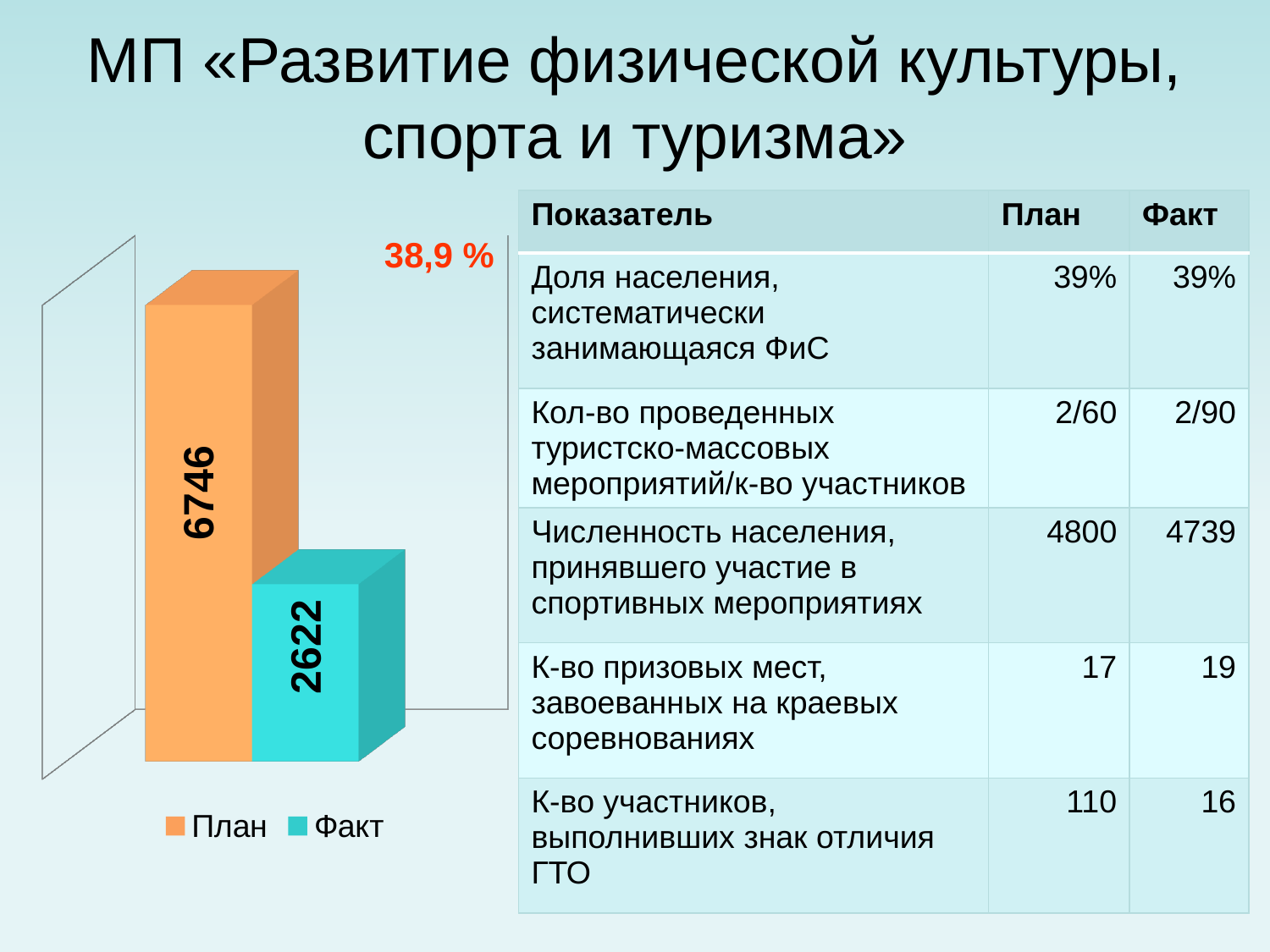
Which bar in the chart is the highest? План How many series does the chart legend list? 2 How many bars are plotted in the chart? 2 What is the difference between the План and Факт values in the chart? 4124 What is the value of the Факт bar in the chart? 2622 What colour is the Факт bar in the chart? Turquoise Which series has the higher bar in the chart, План or Факт? План What is the value of the План bar in the chart? 6746 What kind of chart is shown on the slide? Bar chart Which bar in the chart is the lowest? Факт What percentage is printed in red above the chart? 38,9 %